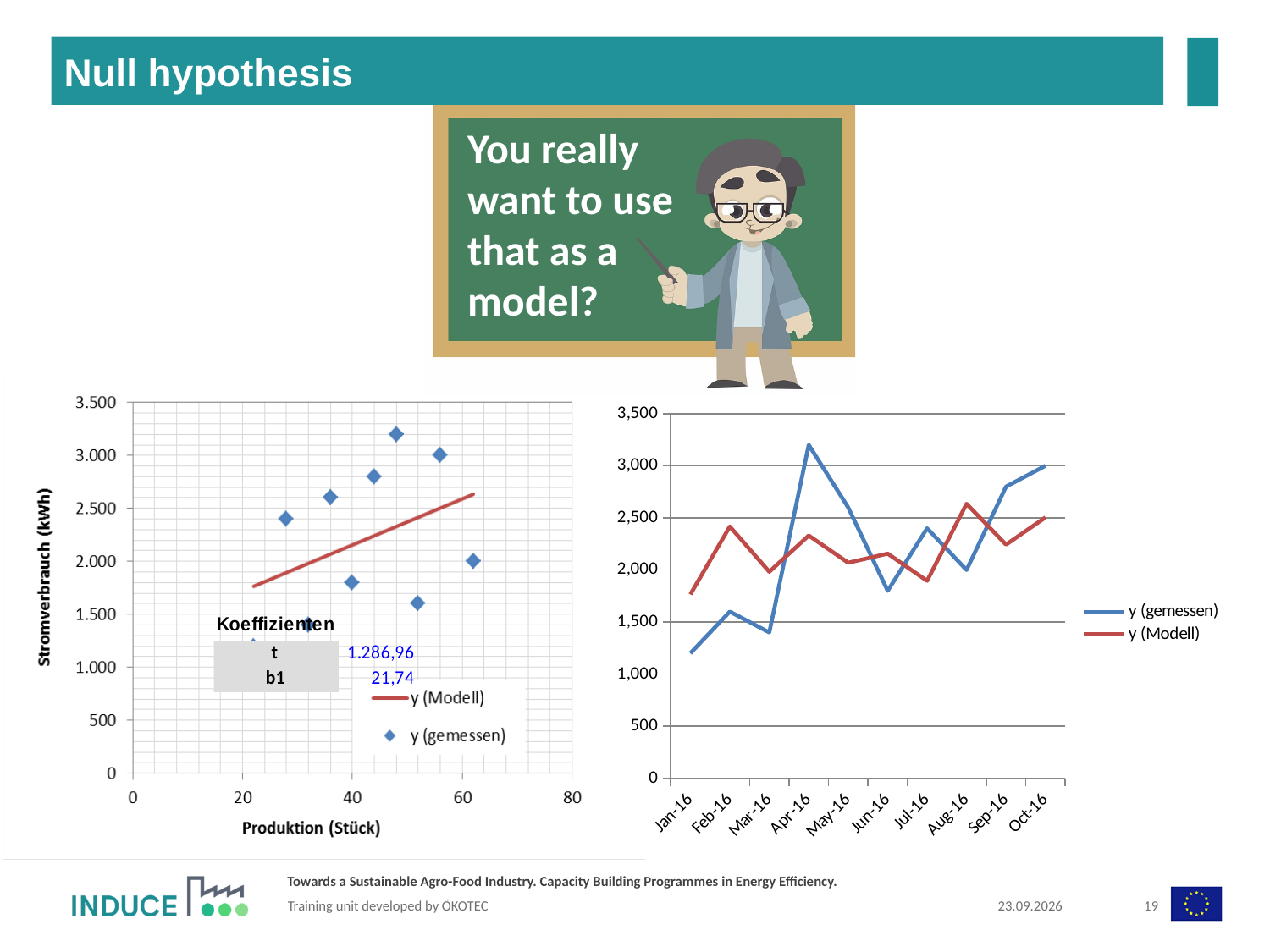
In the right-hand line chart, which month has the lowest value for y (gemessen)? Jan-16 In the right-hand line chart, which month has the highest value for y (gemessen)? Apr-16 What is the x-axis title of the left-hand scatter chart? Produktion (Stück) In the right-hand line chart, is the value of y (gemessen) for Apr-16 greater or less than 3,000? greater In the right-hand line chart, which series has the larger value in Mar-16, y (gemessen) or y (Modell)? y (Modell) What kind of chart is the chart on the left of the slide? scatter chart In the left-hand scatter chart, what value is given for b1 in the Koeffizienten table? 21,74 How many months are shown on the x axis of the right-hand line chart? 10 What kind of chart is the chart on the right of the slide? line chart In the right-hand line chart, is the value of y (Modell) for Jan-16 greater or less than 2,000? less How many series does the legend of the right-hand line chart list? 2 In the right-hand line chart, which series has the larger value in Apr-16, y (gemessen) or y (Modell)? y (gemessen)